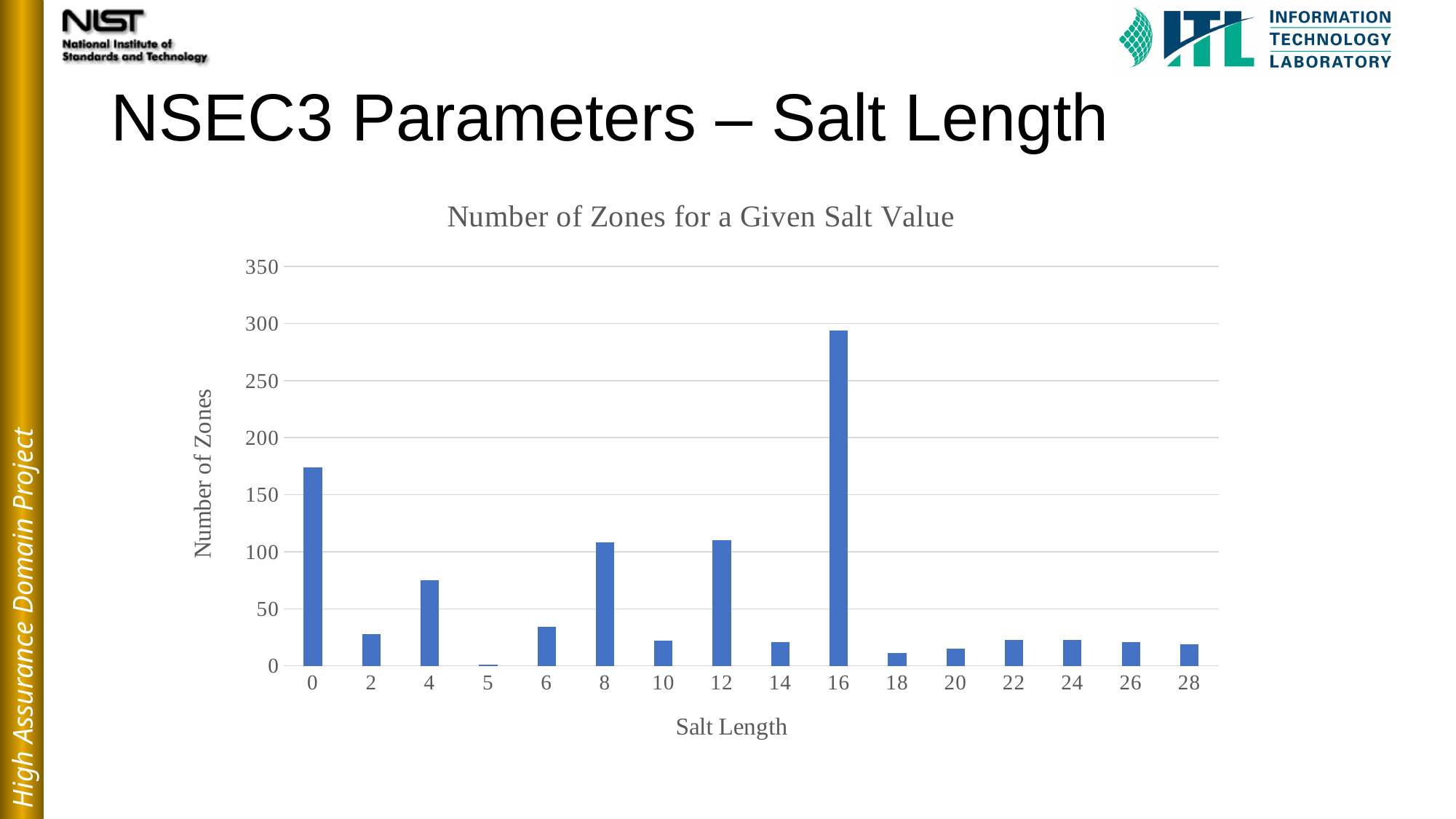
Which has more zones, salt length 4 or salt length 6? 4 What is the title of the chart? Number of Zones for a Given Salt Value Is the number of zones for salt length 6 greater or less than 50? less What type of chart is shown on the slide? bar chart Which has more zones, salt length 0 or salt length 16? 16 How many salt length categories are shown on the x axis? 16 Is the number of zones for salt length 0 greater or less than 150? greater Is the number of zones for salt length 16 greater or less than 250? greater Which salt length has the lowest number of zones? 5 What is the label of the y axis? Number of Zones Which salt length has the highest number of zones? 16